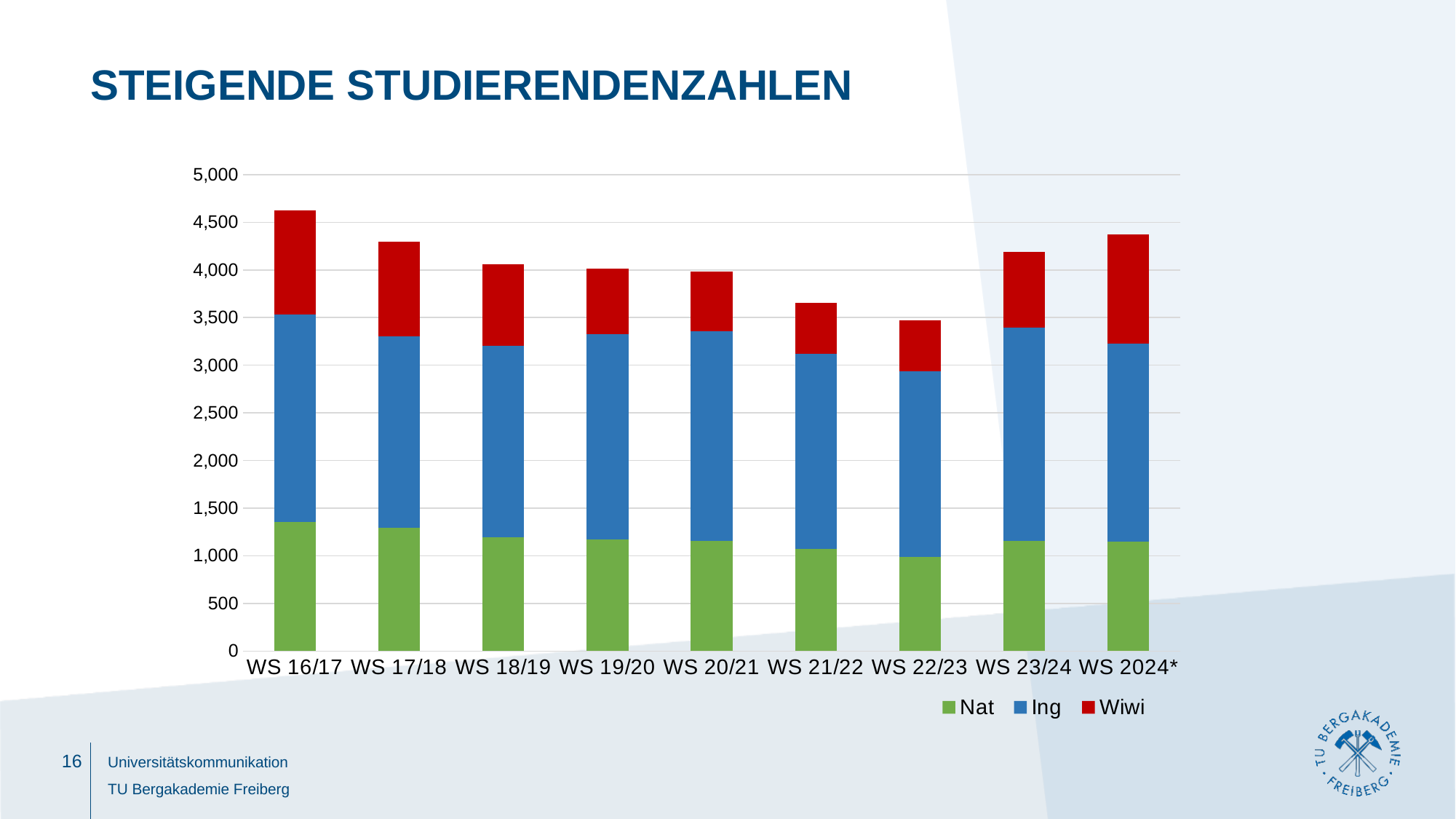
Do the total bars rise or fall from WS 16/17 to WS 22/23? fall Which semester has the lowest total bar? WS 22/23 Which semester has the highest total bar? WS 16/17 Is the Nat value for WS 16/17 greater or less than 1,000? greater Which series is shown in red in the legend? Wiwi Is the total for WS 2024* greater or less than 4,500? less Which has the larger total bar, WS 23/24 or WS 2024*? WS 2024* What kind of chart is shown on the slide? stacked bar chart How many series does the legend list? 3 Is the total for WS 16/17 greater or less than 4,500? greater How many semesters (categories) are shown on the x axis? 9